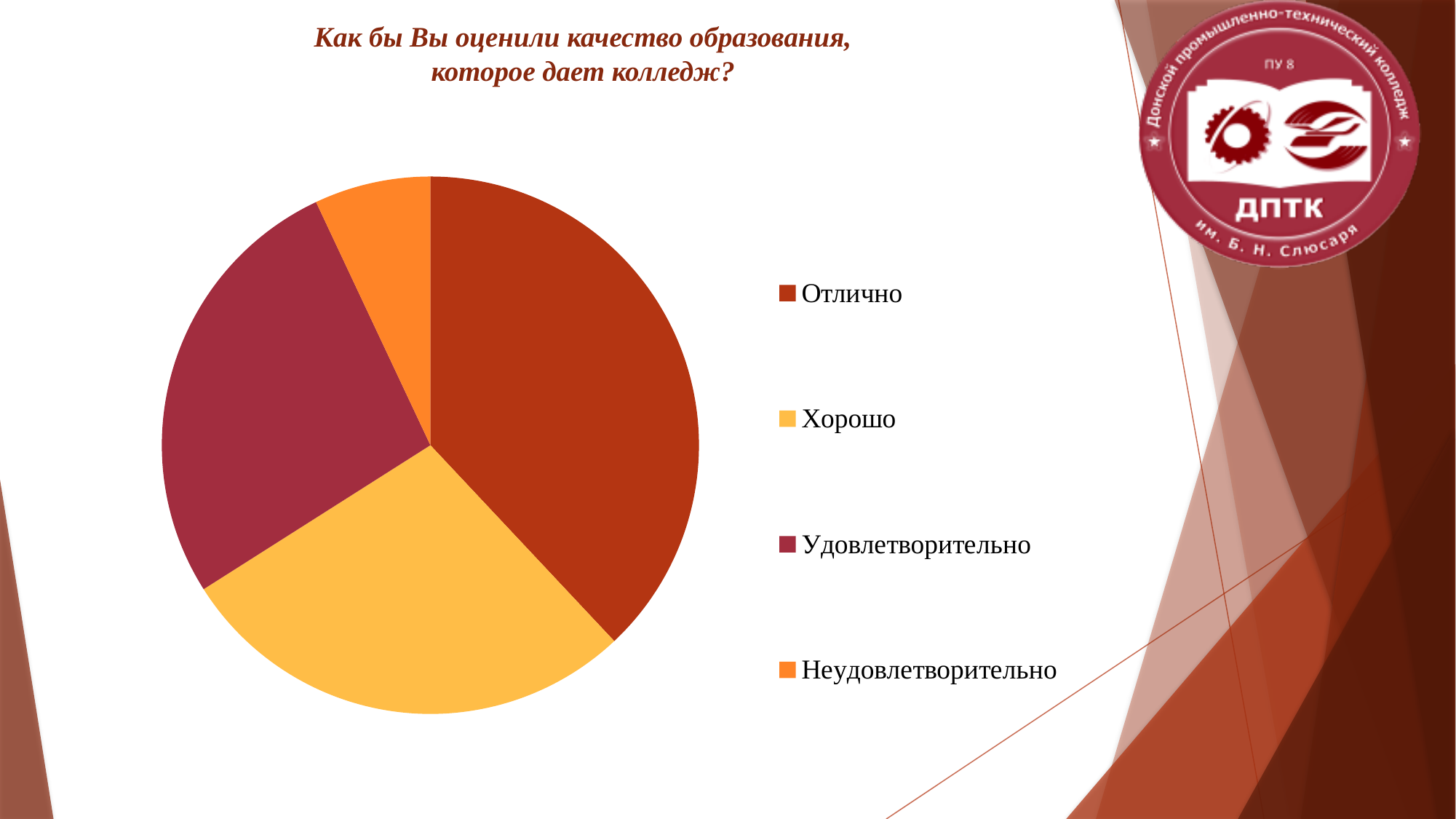
Which slice is larger, Удовлетворительно or Неудовлетворительно? Удовлетворительно Which slice is smaller, Отлично or Неудовлетворительно? Неудовлетворительно What is the title of the chart on the slide? Как бы Вы оценили качество образования, которое дает колледж? Which category is shown in yellow in the pie chart? Хорошо Which category has the smallest slice of the pie chart? Неудовлетворительно How many categories (slices) does the pie chart have? 4 Which category has the largest slice of the pie chart? Отлично Which slice is larger, Отлично or Хорошо? Отлично What kind of chart is shown on the slide? Pie chart